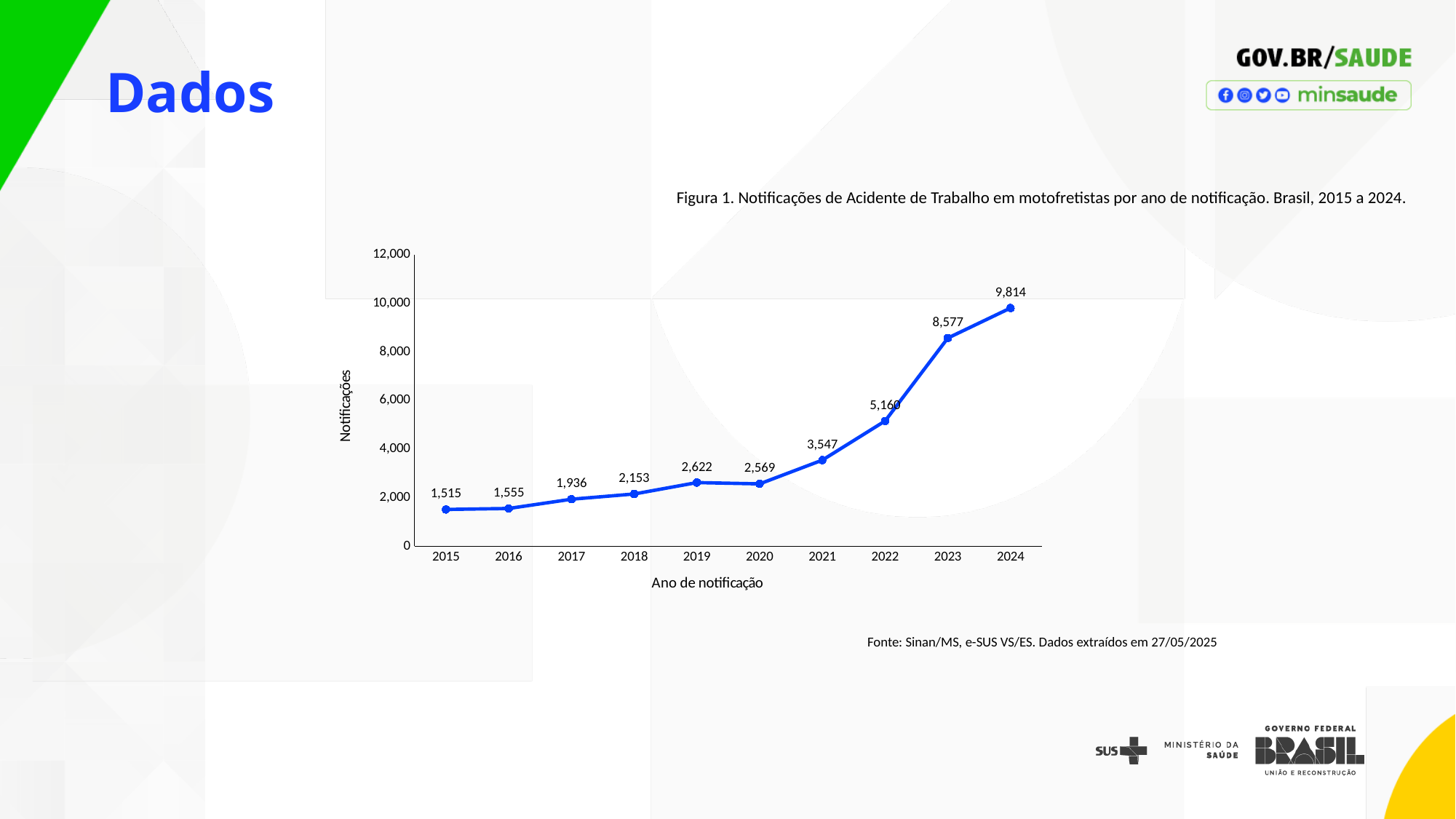
Which year has the lowest number of notifications? 2015 Which year has more notifications, 2019 or 2020? 2019 How many years are plotted on the x axis? 10 Which year has the highest number of notifications? 2024 What is the number of notifications in 2024? 9,814 What is the number of notifications in 2020? 2,569 What is the label of the x axis? Ano de notificação What is the difference in notifications between 2023 and 2022? 3,417 What is the overall trend of notifications from 2015 to 2024? Rising Is the value for 2021 greater or less than 4,000? less What is the number of notifications in 2015? 1,515 What type of chart is shown on the slide? Line chart